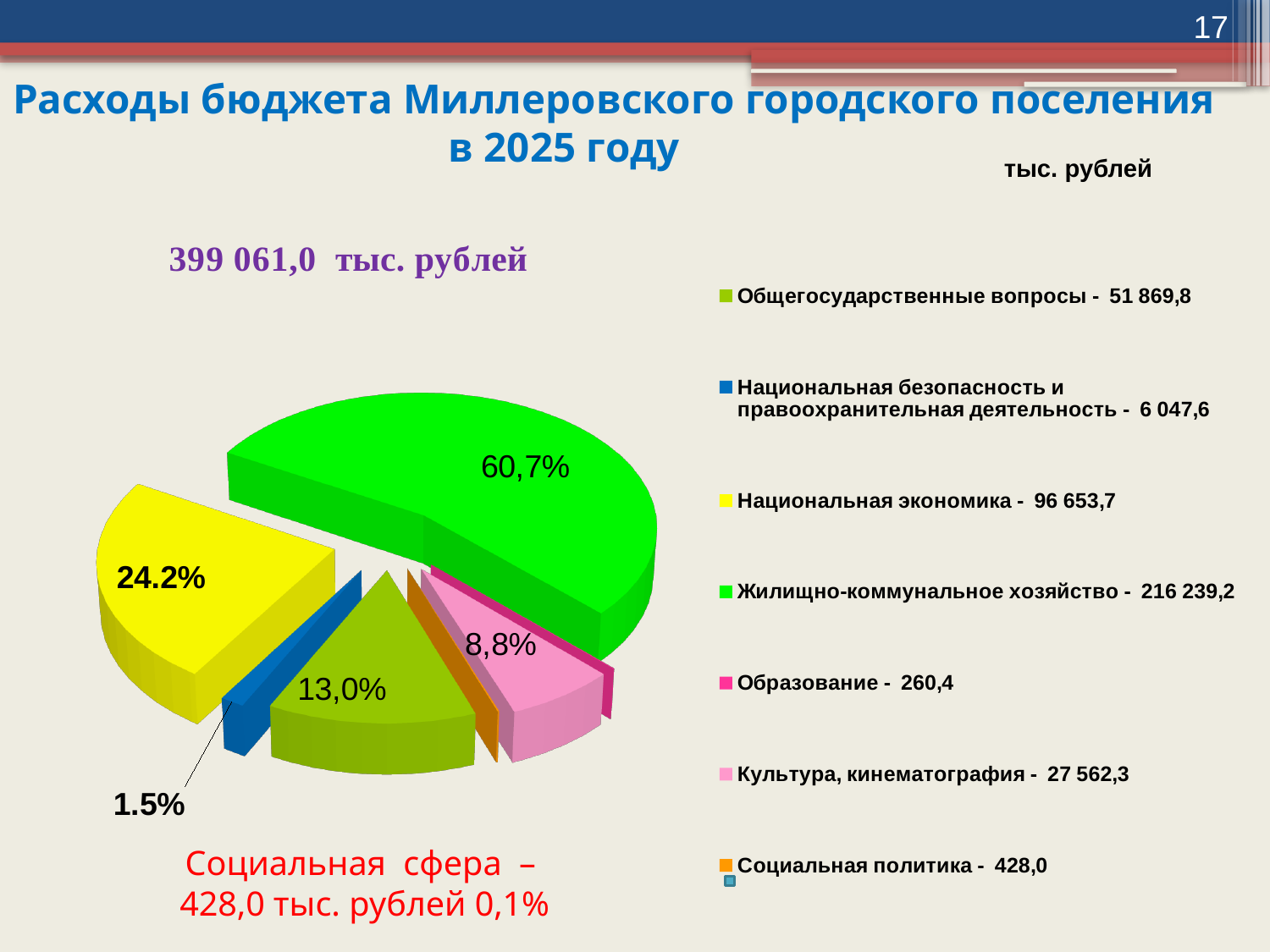
Which is larger: Национальная безопасность и правоохранительная деятельность or Социальная политика? Национальная безопасность и правоохранительная деятельность Which category has the smallest value? Образование What share of the pie does Жилищно-коммунальное хозяйство take? 60,7% What is the difference between Общегосударственные вопросы and Культура, кинематография? 24 307,5 What is the value for Жилищно-коммунальное хозяйство? 216 239,2 What total amount of expenditures is stated above the chart? 399 061,0 тыс. рублей Which category has the largest value? Жилищно-коммунальное хозяйство What is the value for Национальная экономика? 96 653,7 What is the value for Культура, кинематография? 27 562,3 What is the difference between Жилищно-коммунальное хозяйство and Национальная экономика? 119 585,5 How many categories does the legend list? 7 What kind of chart is shown on the slide? pie chart